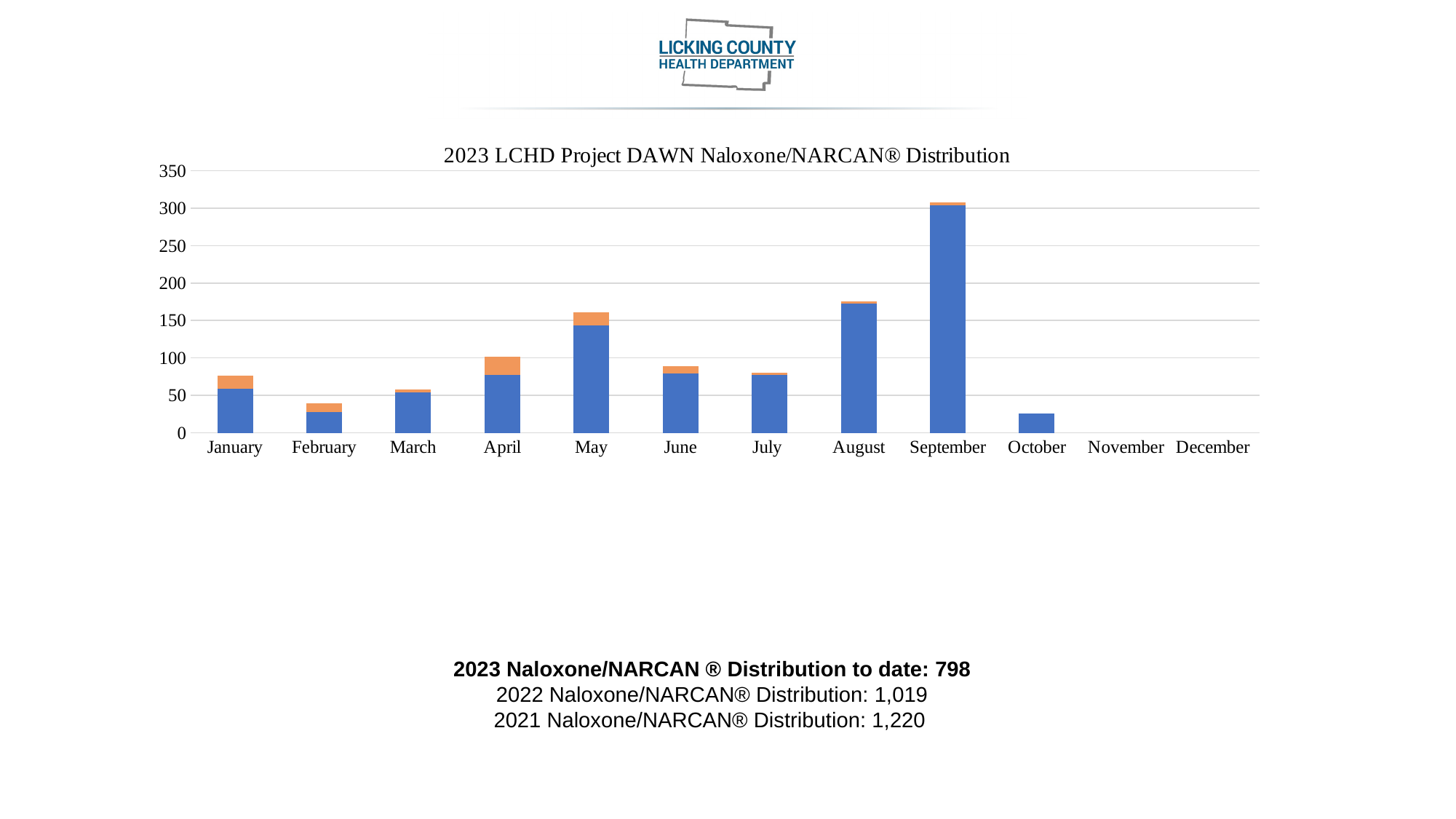
Is the total value for January greater or less than 50? greater Is the total value for October greater or less than 50? less Which month has the tallest bar in the chart? September Do the bar totals rise or fall from February through May? rise Is the total value for August greater or less than 150? greater What kind of chart is shown on the slide? bar chart Which month has the taller bar, August or May? August How many months are shown on the x axis of the chart? 12 What is the title of the chart? 2023 LCHD Project DAWN Naloxone/NARCAN® Distribution